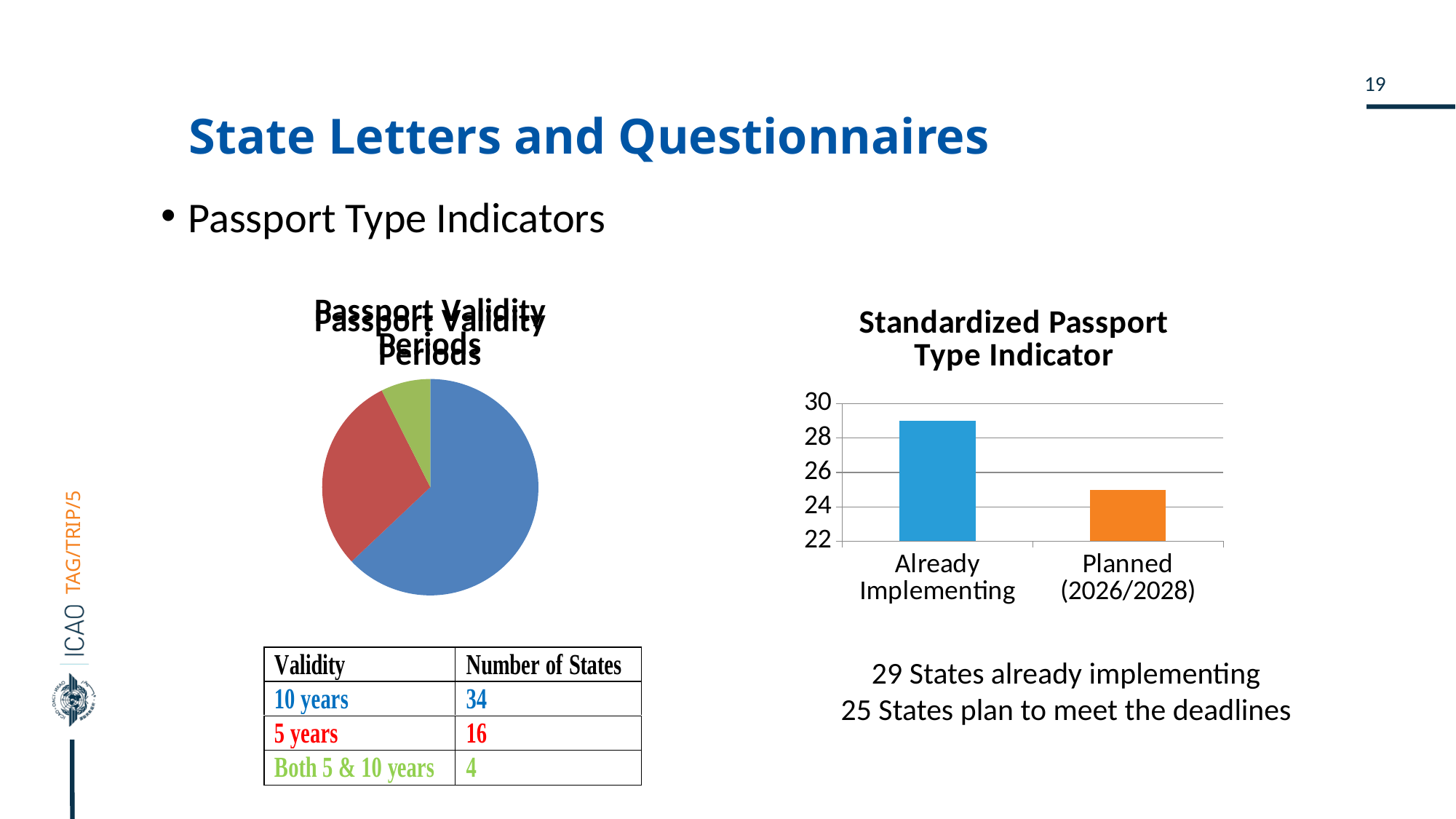
How many slices does the 'Passport Validity Periods' pie chart have? 3 In the 'Standardized Passport Type Indicator' chart, is the value for Planned (2026/2028) greater or less than 26? less In the 'Passport Validity Periods' chart, which validity period has the smallest number of States? Both 5 & 10 years What type of chart is the 'Passport Validity Periods' chart? pie chart In the 'Passport Validity Periods' chart, what is the difference between the number of States with 10 years validity and those with 5 years validity? 18 In the 'Standardized Passport Type Indicator' chart, what is the difference between Already Implementing and Planned (2026/2028)? 4 In the 'Standardized Passport Type Indicator' chart, what is the value for Planned (2026/2028)? 25 What type of chart is the 'Standardized Passport Type Indicator' chart? bar chart How many categories are shown in the 'Standardized Passport Type Indicator' chart? 2 In the 'Passport Validity Periods' chart, how many States have 10 years validity? 34 In the 'Standardized Passport Type Indicator' chart, what is the value for Already Implementing? 29 In the 'Standardized Passport Type Indicator' chart, which category has the higher value? Already Implementing